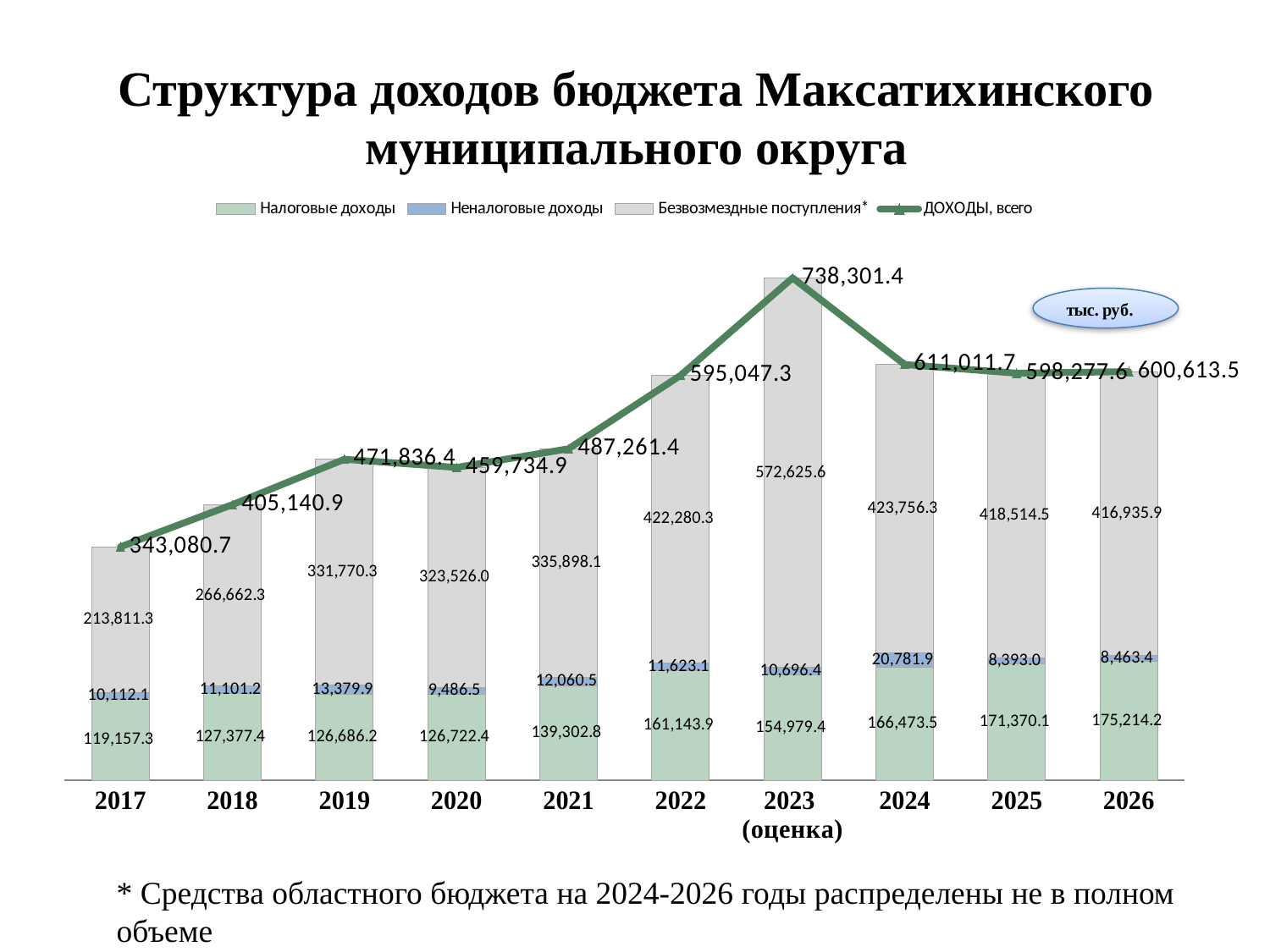
What is the difference between ДОХОДЫ, всего in 2023 and in 2022? 143,254.1 Which year has the larger value of Неналоговые доходы, 2024 or 2025? 2024 How many series does the legend list? 4 How many years are shown on the x axis? 10 In which year is ДОХОДЫ, всего the highest? 2023 In which year is ДОХОДЫ, всего the lowest? 2017 What unit is indicated in the oval label on the chart? тыс. руб. What is the value of Безвозмездные поступления* for 2023? 572,625.6 What is the value of ДОХОДЫ, всего for 2018? 405,140.9 What is the value of Налоговые доходы for 2021? 139,302.8 Does ДОХОДЫ, всего rise or fall from 2017 to 2023? Rise What kind of chart is shown on the slide? Stacked bar chart with a line